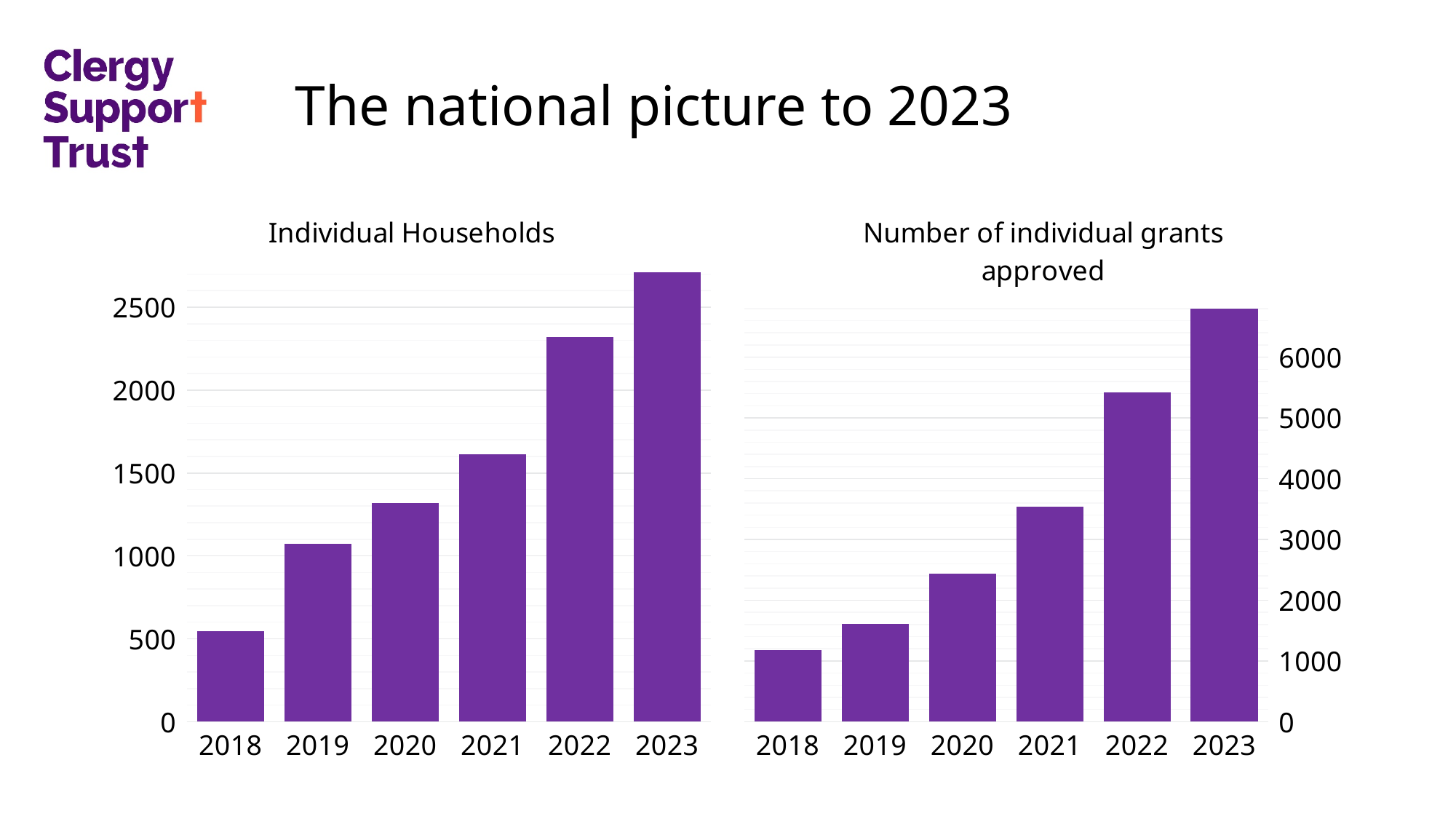
In the 'Number of individual grants approved' chart, is the value for 2020 greater or less than 3000? less In the 'Individual Households' chart, do the values rise or fall from 2018 to 2023? rise In the 'Number of individual grants approved' chart, which year has the highest value? 2023 In the 'Individual Households' chart, which year has the highest value? 2023 In the 'Number of individual grants approved' chart, is the value for 2021 greater or less than 3000? greater What kind of chart is the 'Individual Households' chart? bar chart What is the title of the chart on the right of the slide? Number of individual grants approved In the 'Individual Households' chart, how many years are shown on the x axis? 6 In the 'Number of individual grants approved' chart, which is larger, the value for 2019 or the value for 2021? 2021 In the 'Individual Households' chart, which year has the lowest value? 2018 In the 'Individual Households' chart, is the value for 2019 greater or less than 1000? greater